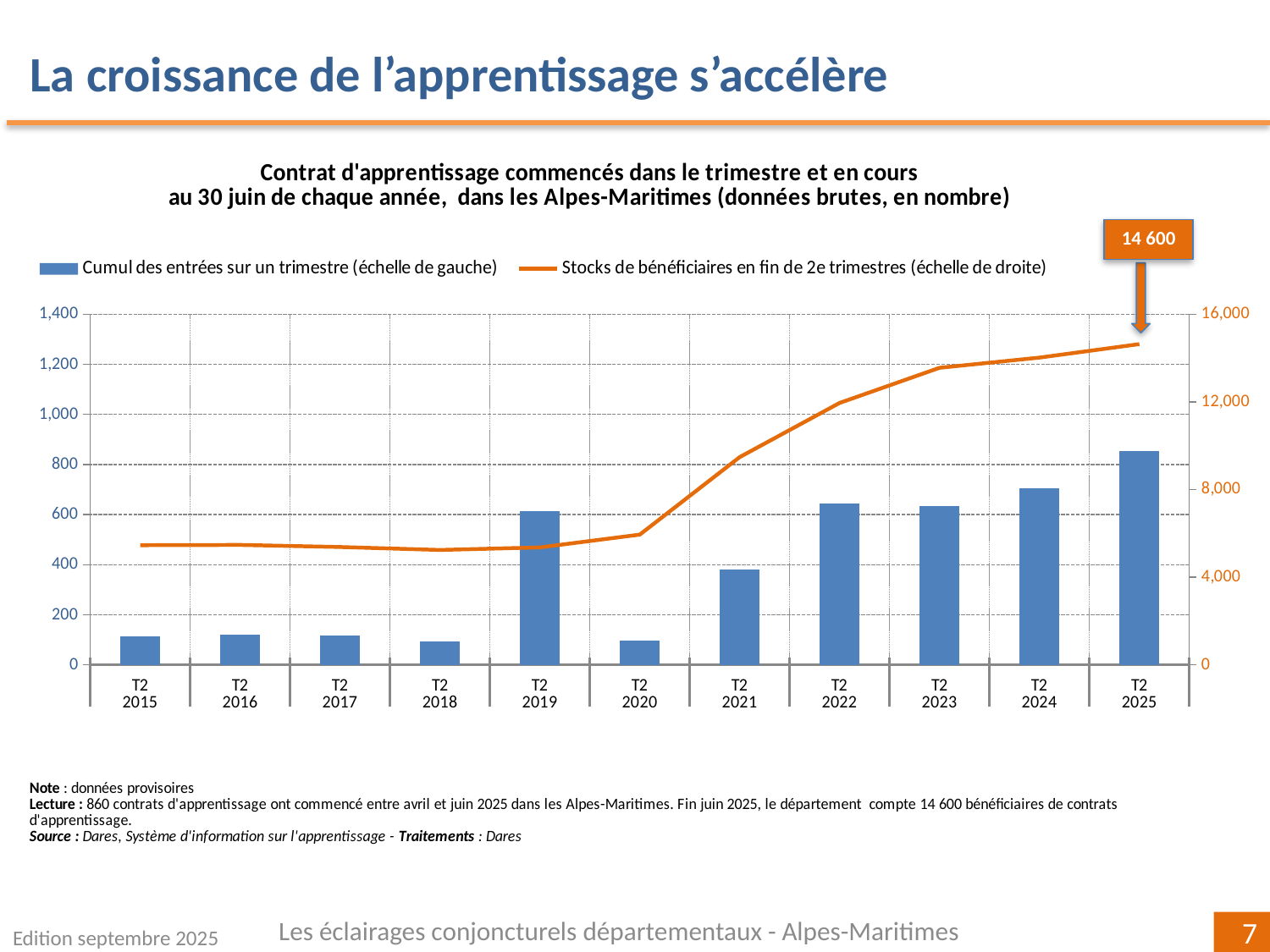
Is the stock of beneficiaries (orange line) at T2 2020 greater or less than 8,000 on the right axis? less In which quarter is the bar for 'Cumul des entrées sur un trimestre' the highest? T2 2025 Is the bar value for T2 2024 greater or less than 600? greater How many quarters (categories) are shown on the x axis? 11 Which bar is taller, T2 2023 or T2 2024? T2 2024 Which bar is taller, T2 2019 or T2 2021? T2 2019 What kind of chart is shown on the slide? A combined bar and line chart What value is printed in the callout for the stock of beneficiaries at T2 2025? 14 600 Does the 'Stocks de bénéficiaires' line rise or fall between T2 2020 and T2 2025? It rises Which series is drawn as the orange line? Stocks de bénéficiaires en fin de 2e trimestres (échelle de droite) How many series does the legend list? 2 Which axis, left or right, is used for the bars 'Cumul des entrées sur un trimestre'? Left